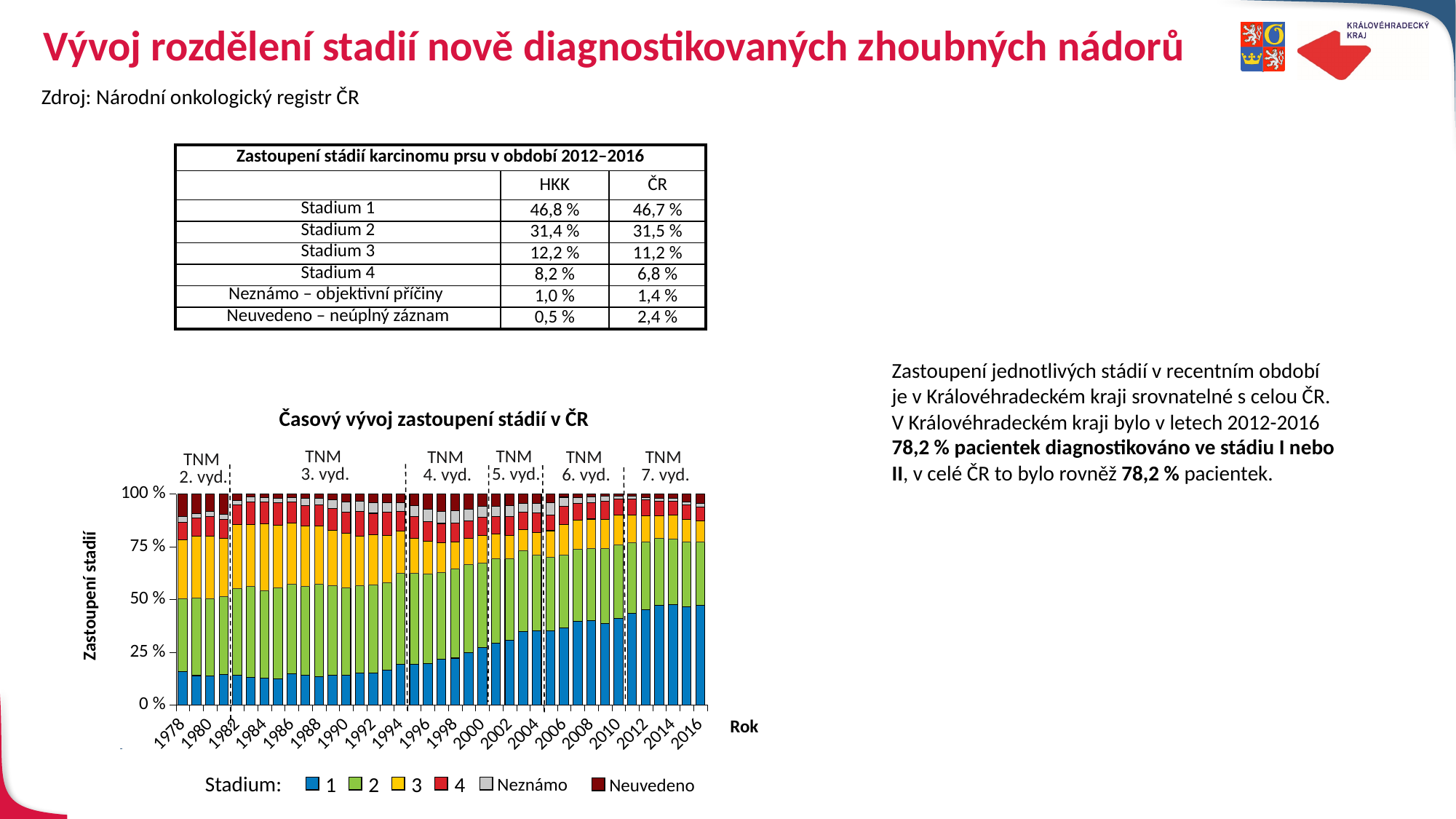
In the chart "Časový vývoj zastoupení stádií v ČR", which is larger in 2016: the share of Stadium 1 or the share of Stadium 2? Stadium 1 In the chart "Časový vývoj zastoupení stádií v ČR", what is the total of each stacked bar? 100 % How many series does the legend of the chart "Časový vývoj zastoupení stádií v ČR" list? 6 In the chart "Časový vývoj zastoupení stádií v ČR", does the share of Stadium 1 rise or fall from 1978 to 2016? Rise In the chart "Časový vývoj zastoupení stádií v ČR", is the share of Stadium 1 in 2016 greater or less than 50 %? less In the chart "Časový vývoj zastoupení stádií v ČR", does the share of Stadium 3 rise or fall from 1978 to 2016? Fall In the chart "Časový vývoj zastoupení stádií v ČR", is the share of Stadium 1 in 1978 greater or less than 25 %? less In the chart "Časový vývoj zastoupení stádií v ČR", which is larger in 1978: the share of Stadium 1 or the share of Stadium 2? Stadium 2 In the chart "Časový vývoj zastoupení stádií v ČR", is the share of Stadium 1 in 2000 greater or less than 25 %? greater What kind of chart is "Časový vývoj zastoupení stádií v ČR"? Stacked bar chart In the chart "Časový vývoj zastoupení stádií v ČR", what colour represents Stadium 1 in the legend? Blue In the chart "Časový vývoj zastoupení stádií v ČR", how many year labels are shown on the x axis? 20